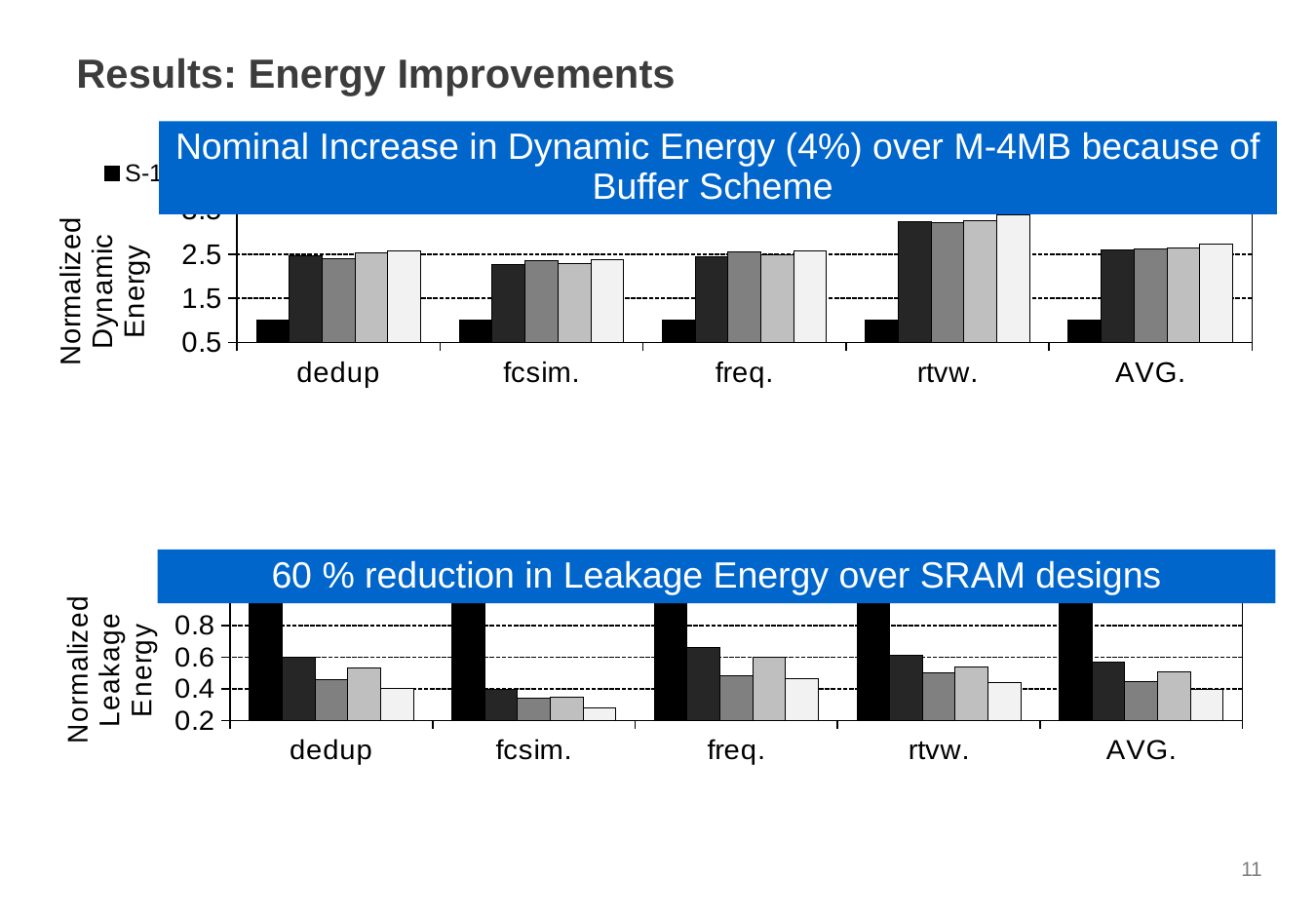
What kind of chart is the top chart on the slide? bar chart In the top chart (Normalized Dynamic Energy), how many bars are plotted for each category? 5 What is the y-axis title of the bottom chart? Normalized Leakage Energy How many categories are shown on the x axis of the top chart (Normalized Dynamic Energy)? 5 In the bottom chart (Normalized Leakage Energy), is the value of the first (black) bar for dedup greater or less than 0.8? greater In the top chart (Normalized Dynamic Energy), is the value of the last (lightest) bar for rtvw. greater or less than 2.5? greater In the bottom chart (Normalized Leakage Energy), which category has the lowest last (lightest) bar? fcsim. In the bottom chart (Normalized Leakage Energy), is the value of the last (lightest) bar for fcsim. greater or less than 0.4? less How many categories are shown on the x axis of the bottom chart (Normalized Leakage Energy)? 5 In the top chart (Normalized Dynamic Energy), which category has the tallest bars? rtvw. What is the title shown in the blue banner above the bottom chart? 60 % reduction in Leakage Energy over SRAM designs